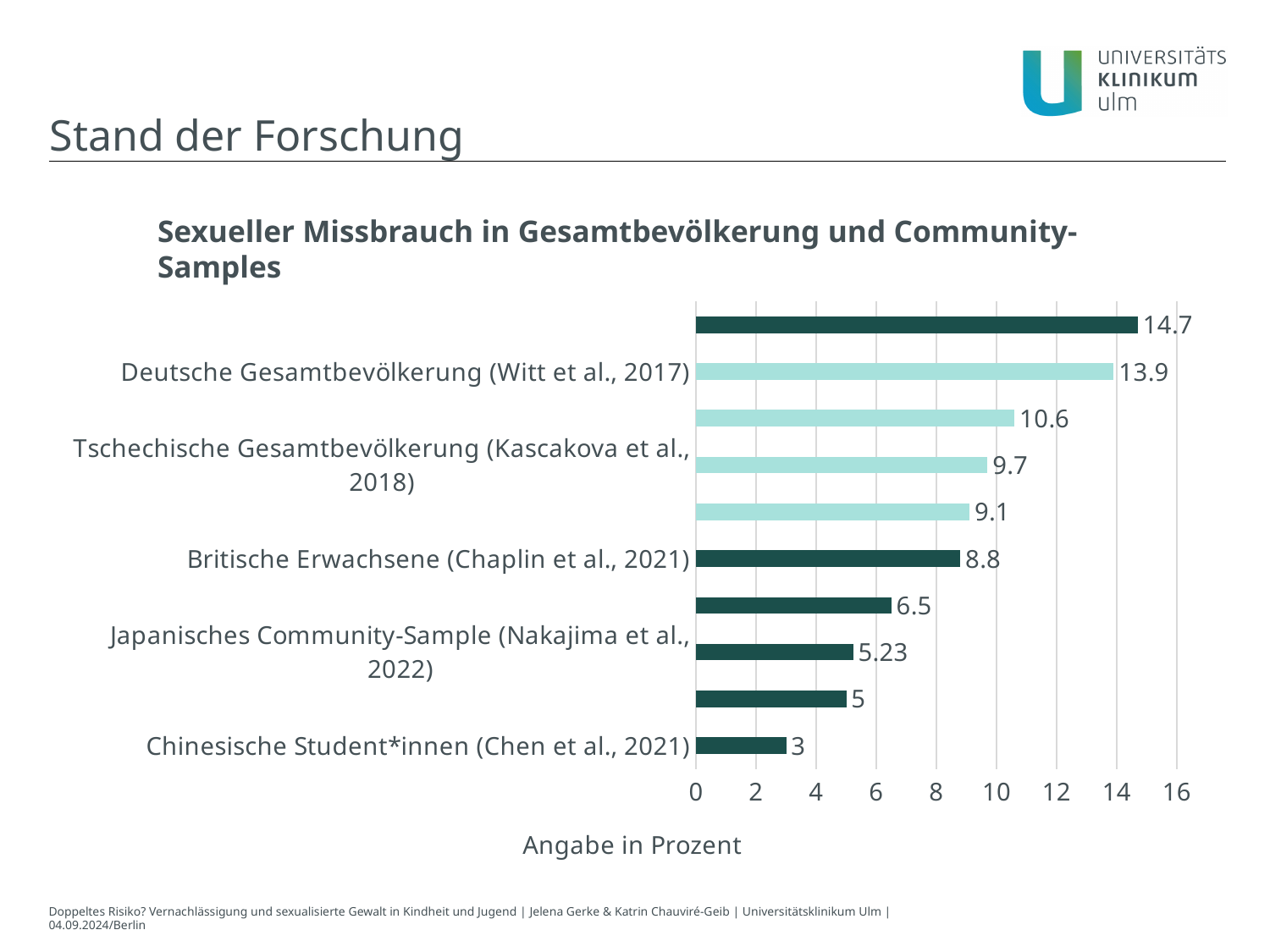
What is the largest value shown on the chart? 14.7 What is the value for Japanisches Community-Sample (Nakajima et al., 2022)? 5.23 What is the value for Tschechische Gesamtbevölkerung (Kascakova et al., 2018)? 9.7 What is the title of the x axis? Angabe in Prozent Which is larger, the value for Tschechische Gesamtbevölkerung (Kascakova et al., 2018) or for Japanisches Community-Sample (Nakajima et al., 2022)? Tschechische Gesamtbevölkerung (Kascakova et al., 2018) How many bars are plotted on the chart? 10 What is the value for Deutsche Gesamtbevölkerung (Witt et al., 2017)? 13.9 What is the value for Chinesische Student*innen (Chen et al., 2021)? 3 What kind of chart is shown? Bar chart Which labelled category has the lowest value? Chinesische Student*innen (Chen et al., 2021) What is the value for Britische Erwachsene (Chaplin et al., 2021)? 8.8 What is the difference between the values for Deutsche Gesamtbevölkerung (Witt et al., 2017) and Britische Erwachsene (Chaplin et al., 2021)? 5.1